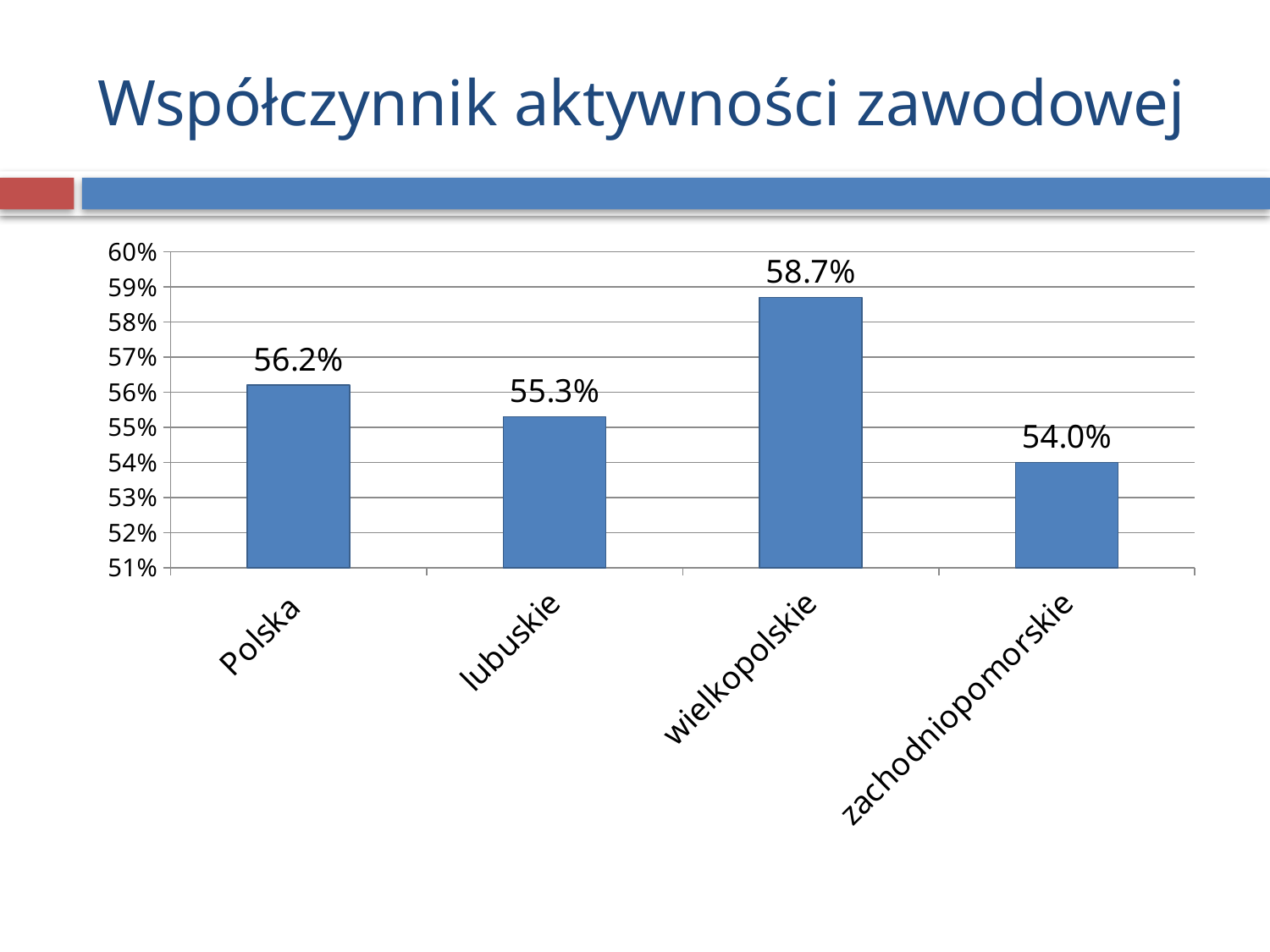
Which category has the lowest value? zachodniopomorskie Is the value for zachodniopomorskie greater or less than 55%? less What is the value for lubuskie? 55.3% What is the difference between the values for wielkopolskie and zachodniopomorskie? 4.7% What is the value for zachodniopomorskie? 54.0% What is the difference between the values for Polska and lubuskie? 0.9% How many categories are shown on the chart? 4 What is the value for Polska? 56.2% Which is larger, the value for Polska or the value for lubuskie? Polska What is the value for wielkopolskie? 58.7% What kind of chart is shown on the slide? bar chart Which category has the highest value? wielkopolskie